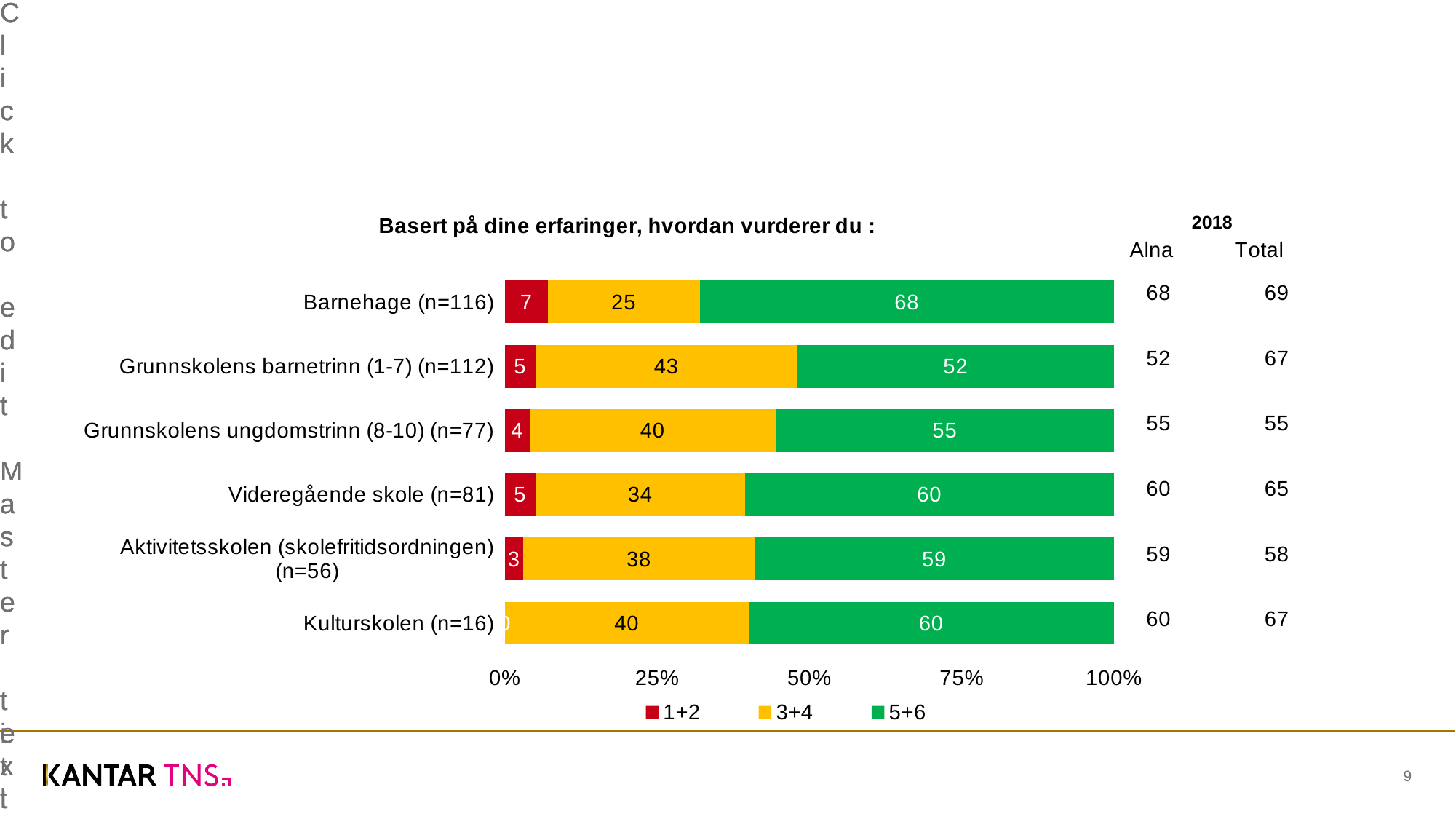
Which is larger, the 5+6 value for Videregående skole (n=81) or for Grunnskolens ungdomstrinn (8-10) (n=77)? Videregående skole (n=81) What is the total of the stacked bar for Barnehage (n=116)? 100 How many series does the legend list? 3 What is the value of the 3+4 segment for Grunnskolens barnetrinn (1-7) (n=112)? 43 What is the value of the 5+6 segment for Barnehage (n=116)? 68 Which category has the lowest 5+6 value? Grunnskolens barnetrinn (1-7) (n=112) Which category has the highest 5+6 value? Barnehage (n=116) What is the title of the chart? Basert på dine erfaringer, hvordan vurderer du : What is the value of the 1+2 segment for Aktivitetsskolen (skolefritidsordningen) (n=56)? 3 What kind of chart is shown on the slide? Stacked bar chart How many categories are shown in the chart? 6 What is the difference between the 3+4 values for Grunnskolens barnetrinn (1-7) (n=112) and Barnehage (n=116)? 18